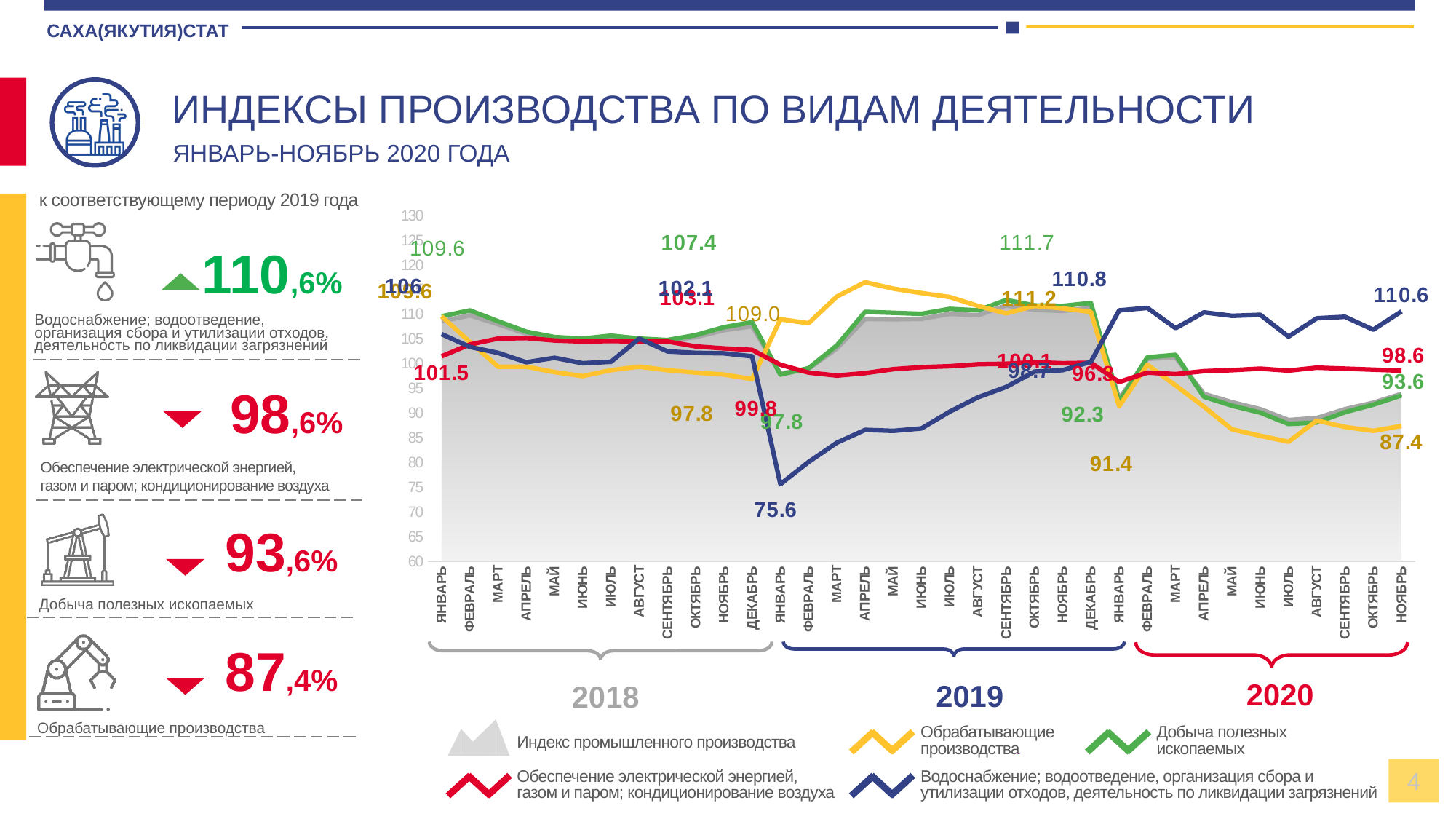
What is the value of the water supply series in January 2019? 75.6 What is the value of the electricity supply series (Обеспечение электрической энергией...) in November 2020? 98.6 In November 2020, which is larger: the water supply series or the manufacturing series? water supply series What is the value of the water supply series (Водоснабжение; водоотведение...) in November 2020? 110.6 Which years are marked with brackets below the x axis of the chart? 2018, 2019, 2020 What kind of chart is shown on the slide? combination area and line chart What is the difference between the water supply value (110.6) and the manufacturing value (87.4) in November 2020? 23.2 How many series does the chart legend list? 5 In which month does the water supply series reach its lowest value? January 2019 What is the value of the manufacturing series (Обрабатывающие производства) in November 2020? 87.4 Which series has the highest value in November 2020? Водоснабжение; водоотведение, организация сбора и утилизации отходов, деятельность по ликвидации загрязнений What is the value of the mining series (Добыча полезных ископаемых) in November 2020? 93.6